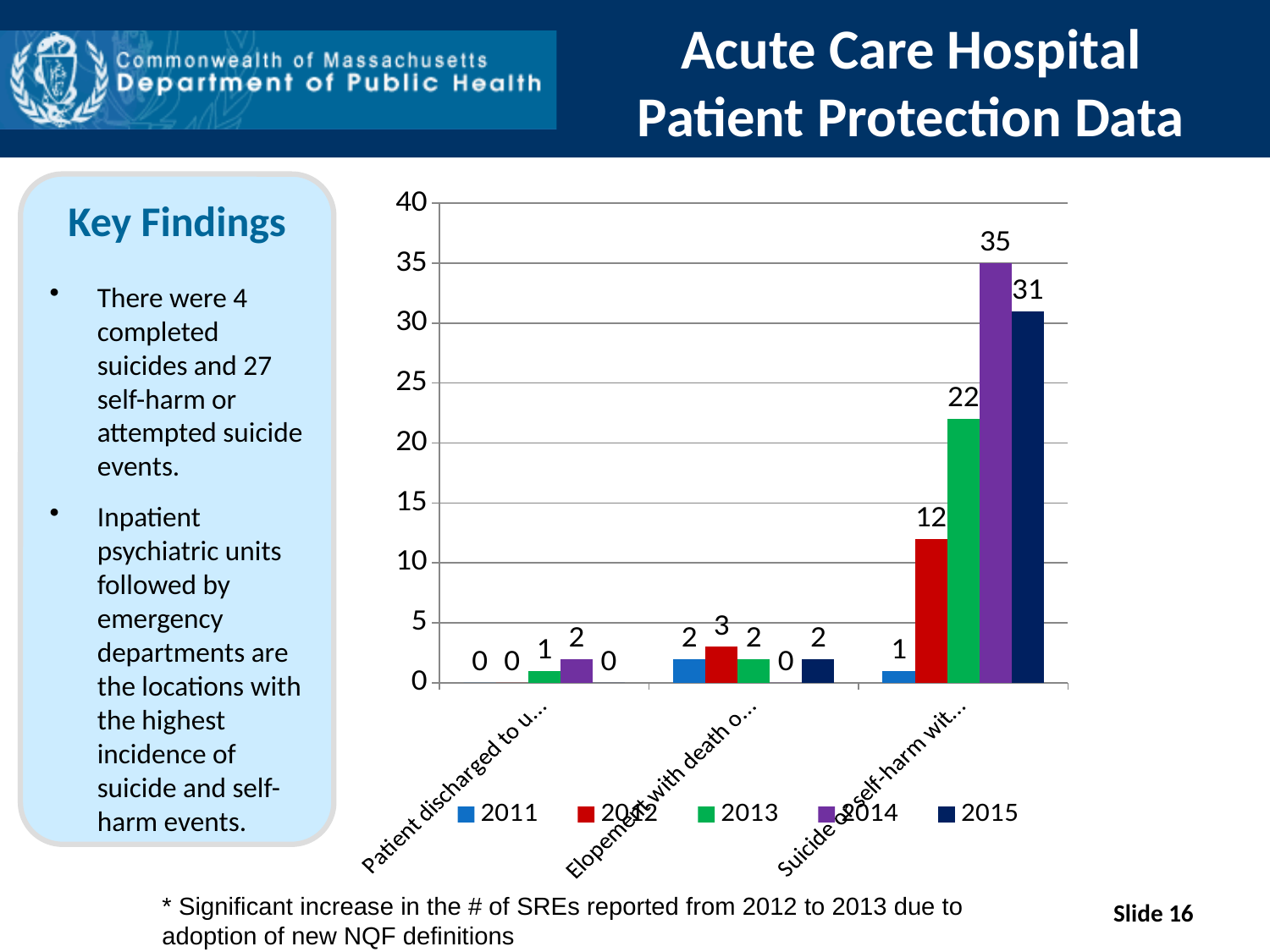
Which year has the highest value in the 'Suicide or self-harm' category? 2014 How many categories are shown on the x axis? 3 What is the value for 2014 in the 'Suicide or self-harm' category? 35 How many series does the legend list? 5 What kind of chart is shown on the slide? Bar chart Which is larger in the 'Suicide or self-harm' category: the 2013 value or the 2015 value? 2015 Which year has the lowest value in the 'Suicide or self-harm' category? 2011 What is the value for 2012 in the 'Suicide or self-harm' category? 12 What is the value for 2014 in the 'Patient discharged' category? 2 Is the 2013 value in the 'Suicide or self-harm' category greater or less than 20? greater What is the value for 2012 in the 'Elopement with death' category? 3 What is the difference between the 2014 and 2015 values in the 'Suicide or self-harm' category? 4